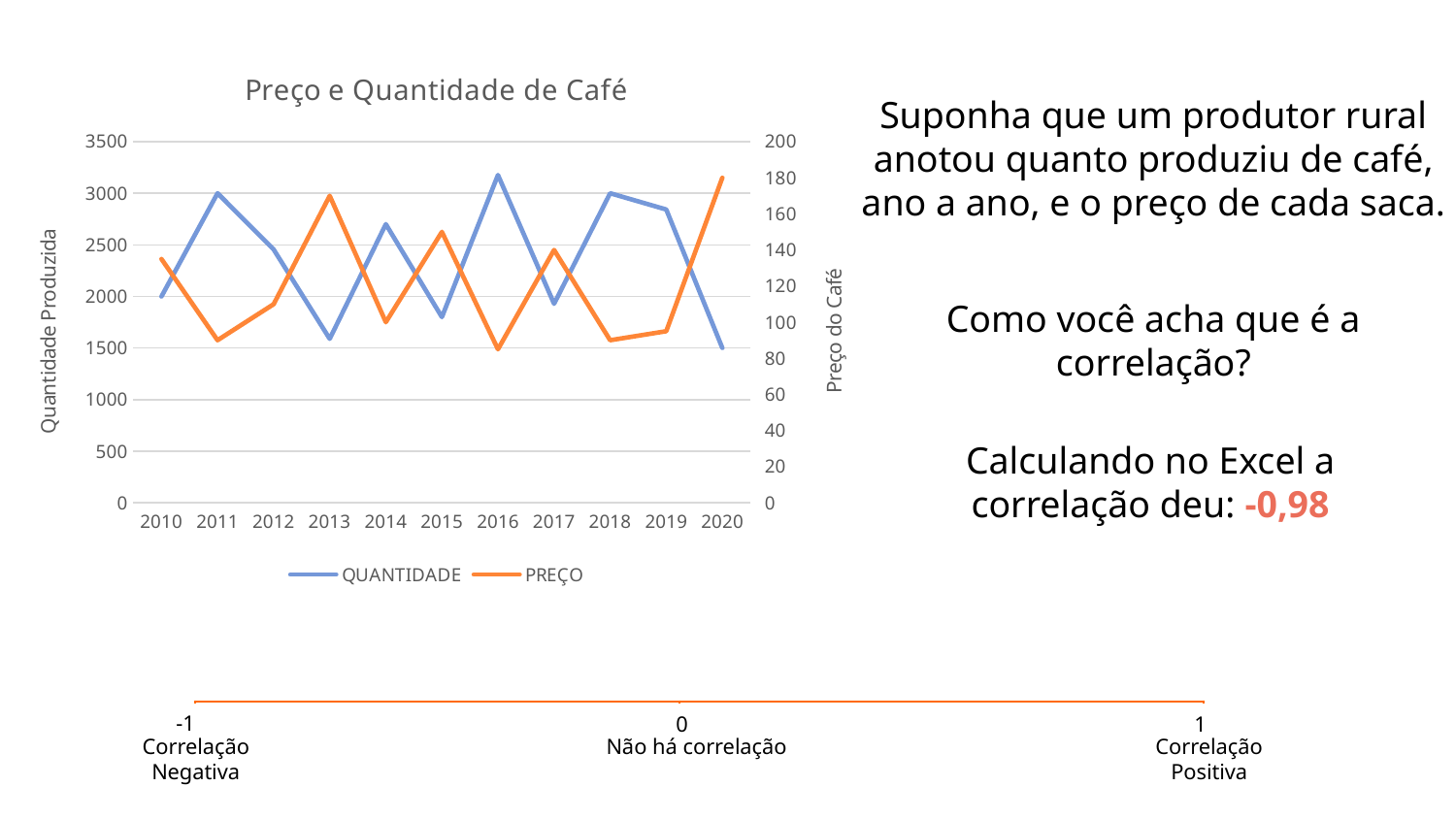
What is the title of the chart? Preço e Quantidade de Café Which year has the highest QUANTIDADE value in the chart? 2016 How many series does the chart legend list? 2 What kind of chart is shown on the slide? line chart Is the QUANTIDADE value for 2013 greater or less than 2000? less Is the PREÇO value for 2016 greater or less than 100? less Is the PREÇO value for 2020 greater or less than 160? greater What is the label of the right-hand vertical axis of the chart? Preço do Café Which is larger, the QUANTIDADE value for 2011 or for 2013? 2011 How many years are plotted along the x axis of the chart? 11 Which is larger, the PREÇO value for 2013 or for 2014? 2013